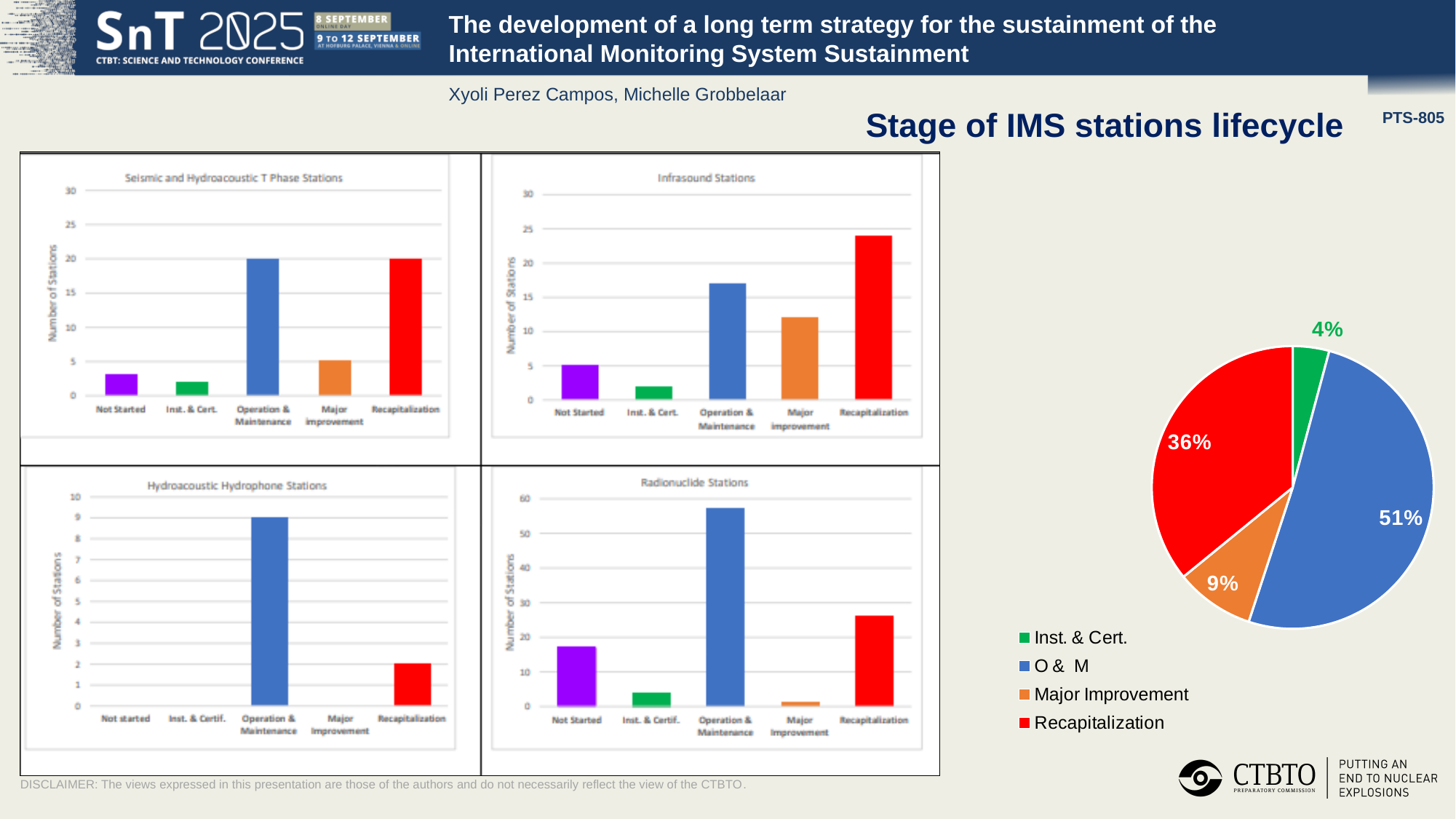
In the pie chart, which category has the largest slice? O & M In the pie chart, what share is labelled for O & M? 51% How many categories does the pie chart's legend list? 4 In the Infrasound Stations chart, is the value for Not Started greater or less than 10? less In the Infrasound Stations chart, which category has the highest number of stations? Recapitalization In the Hydroacoustic Hydrophone Stations chart, how many stations are in Recapitalization? 2 In the Hydroacoustic Hydrophone Stations chart, how many stations are in Operation & Maintenance? 9 In the Seismic and Hydroacoustic T Phase Stations chart, how many stations are in Operation & Maintenance? 20 In the pie chart, which category has the smallest slice? Inst. & Cert. In the Radionuclide Stations chart, is the value for Operation & Maintenance greater or less than 50? greater In the pie chart, how many percentage points larger is the Recapitalization slice than the Major Improvement slice? 27 percentage points What kind of chart is the Radionuclide Stations chart? Bar chart